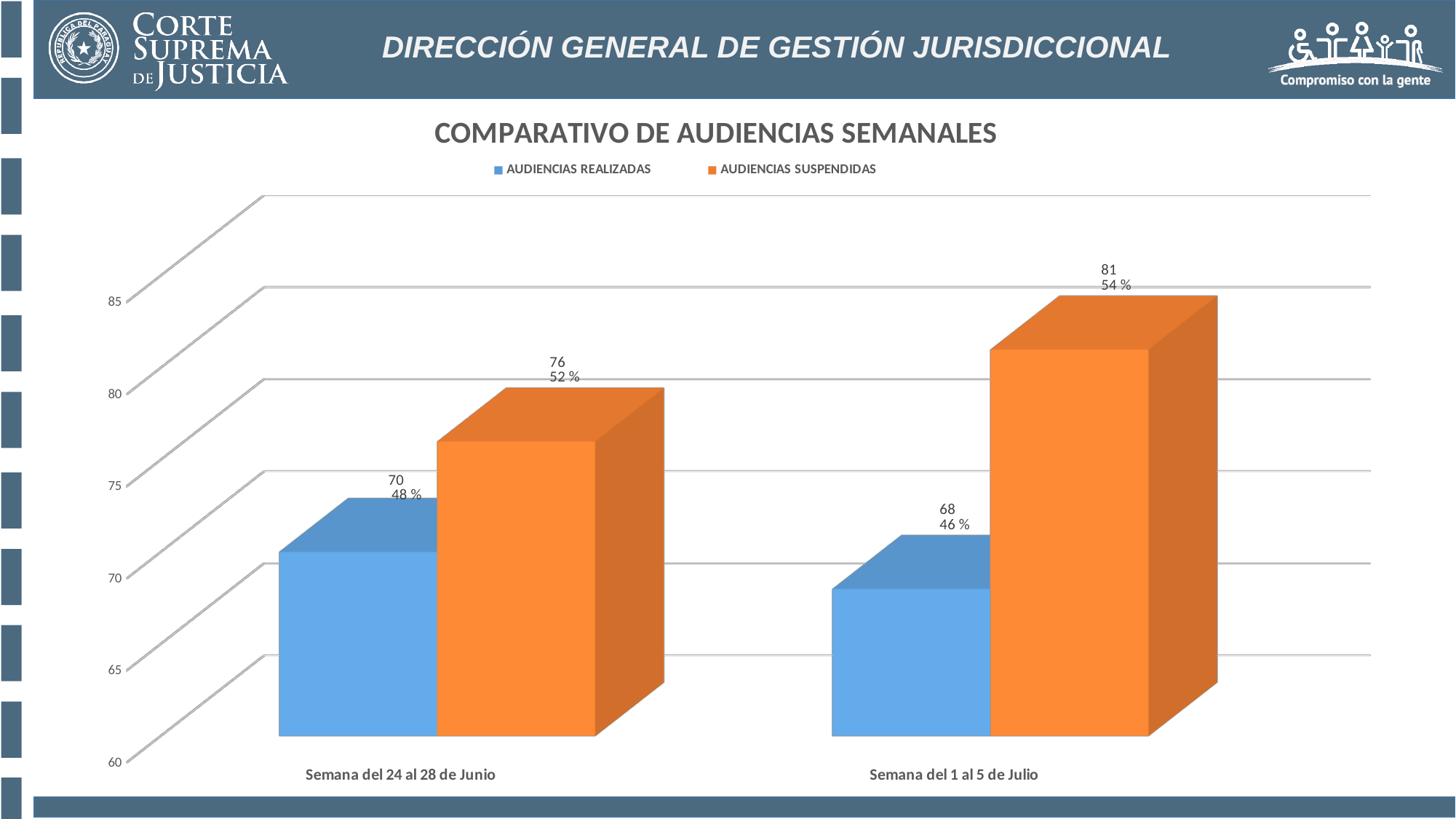
Which is larger for Semana del 24 al 28 de Junio: AUDIENCIAS REALIZADAS or AUDIENCIAS SUSPENDIDAS? AUDIENCIAS SUSPENDIDAS Which week has the lowest value for AUDIENCIAS REALIZADAS? Semana del 1 al 5 de Julio What kind of chart is shown on the slide? Bar chart What is the value of AUDIENCIAS SUSPENDIDAS for Semana del 1 al 5 de Julio? 81 Which week has the highest value for AUDIENCIAS SUSPENDIDAS? Semana del 1 al 5 de Julio What is the difference between AUDIENCIAS SUSPENDIDAS and AUDIENCIAS REALIZADAS for Semana del 1 al 5 de Julio? 13 What percentage is shown for AUDIENCIAS REALIZADAS in Semana del 1 al 5 de Julio? 46 % What is the value of AUDIENCIAS SUSPENDIDAS for Semana del 24 al 28 de Junio? 76 What is the title of the chart? COMPARATIVO DE AUDIENCIAS SEMANALES How many series does the legend list? 2 How many weeks (categories) are shown on the x axis? 2 What is the value of AUDIENCIAS REALIZADAS for Semana del 24 al 28 de Junio? 70